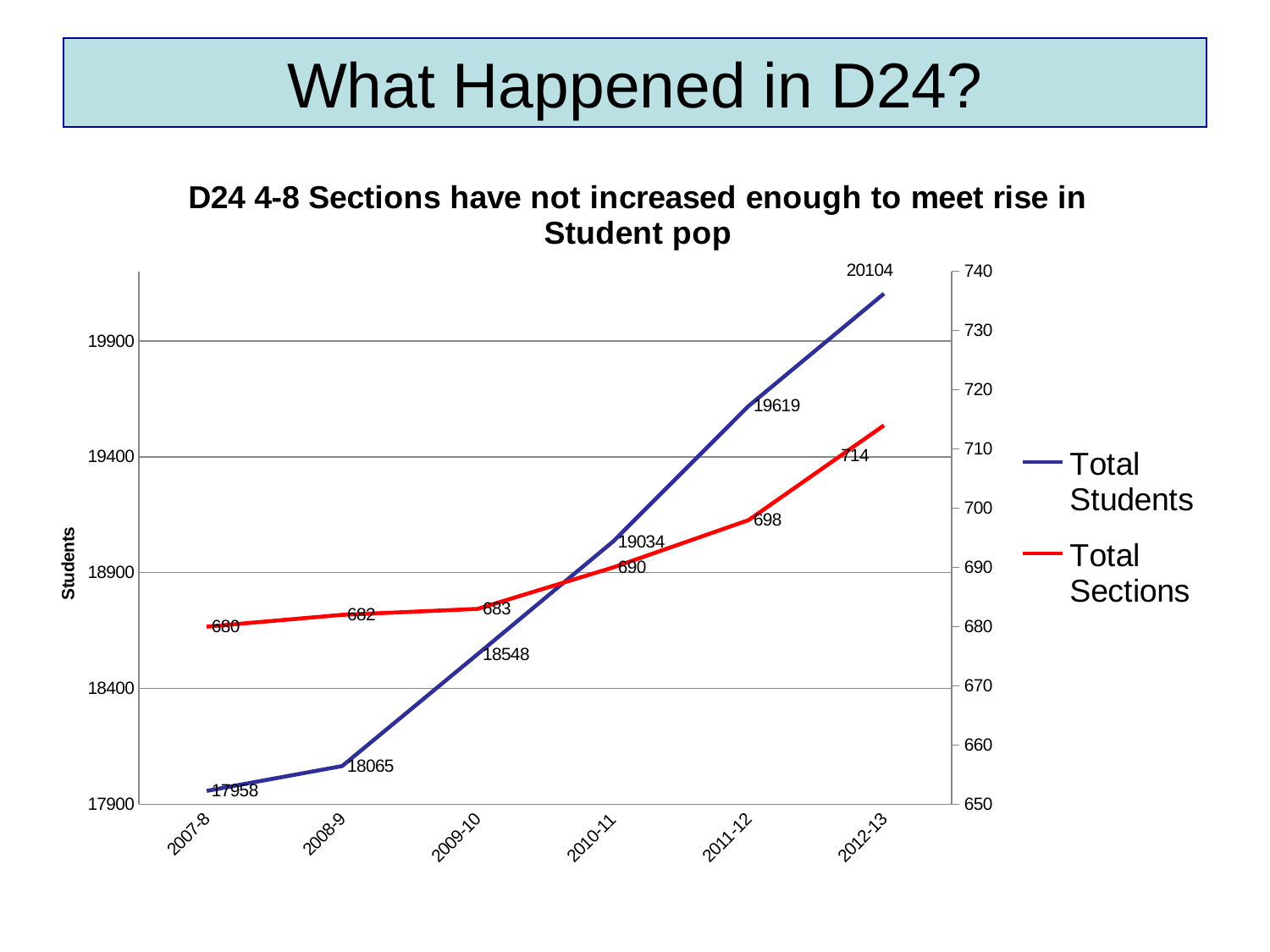
What is the Total Sections value for 2009-10? 683 Which year has the highest Total Students value? 2012-13 How many years are shown on the x axis? 6 What kind of chart is shown? line chart What is the difference between Total Students in 2012-13 and 2007-8? 2146 What is the difference between Total Sections in 2012-13 and 2011-12? 16 What is the Total Students value for 2012-13? 20104 What is the Total Students value for 2007-8? 17958 How many series does the legend list? 2 Is the Total Students value for 2010-11 greater or less than the value for 2009-10? greater What is the Total Sections value for 2011-12? 698 Which year has the lowest Total Sections value? 2007-8